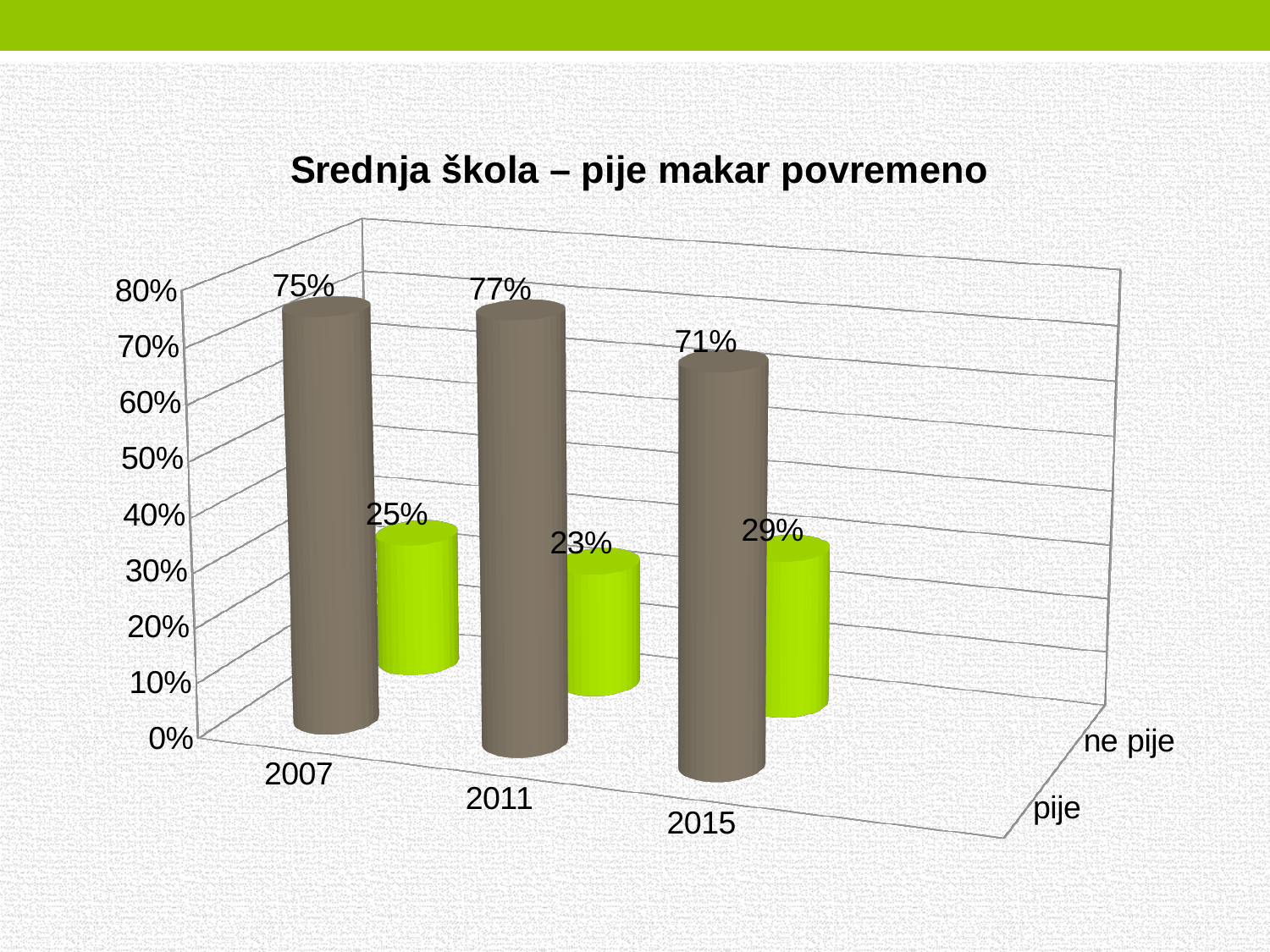
In which year is the "ne pije" value lowest? 2011 Which is larger, the "ne pije" value for 2007 or for 2015? 2015 What is the title of the chart? Srednja škola – pije makar povremeno What is the value for "ne pije" in 2011? 23% What is the difference between the "pije" values for 2011 and 2015? 6% How many years are shown on the x axis? 3 How many data series are plotted in the chart? 2 What is the value for "pije" in 2007? 75% What is the value for "pije" in 2011? 77% In which year is the "pije" value highest? 2011 What kind of chart is shown on the slide? Bar chart What is the value for "ne pije" in 2015? 29%